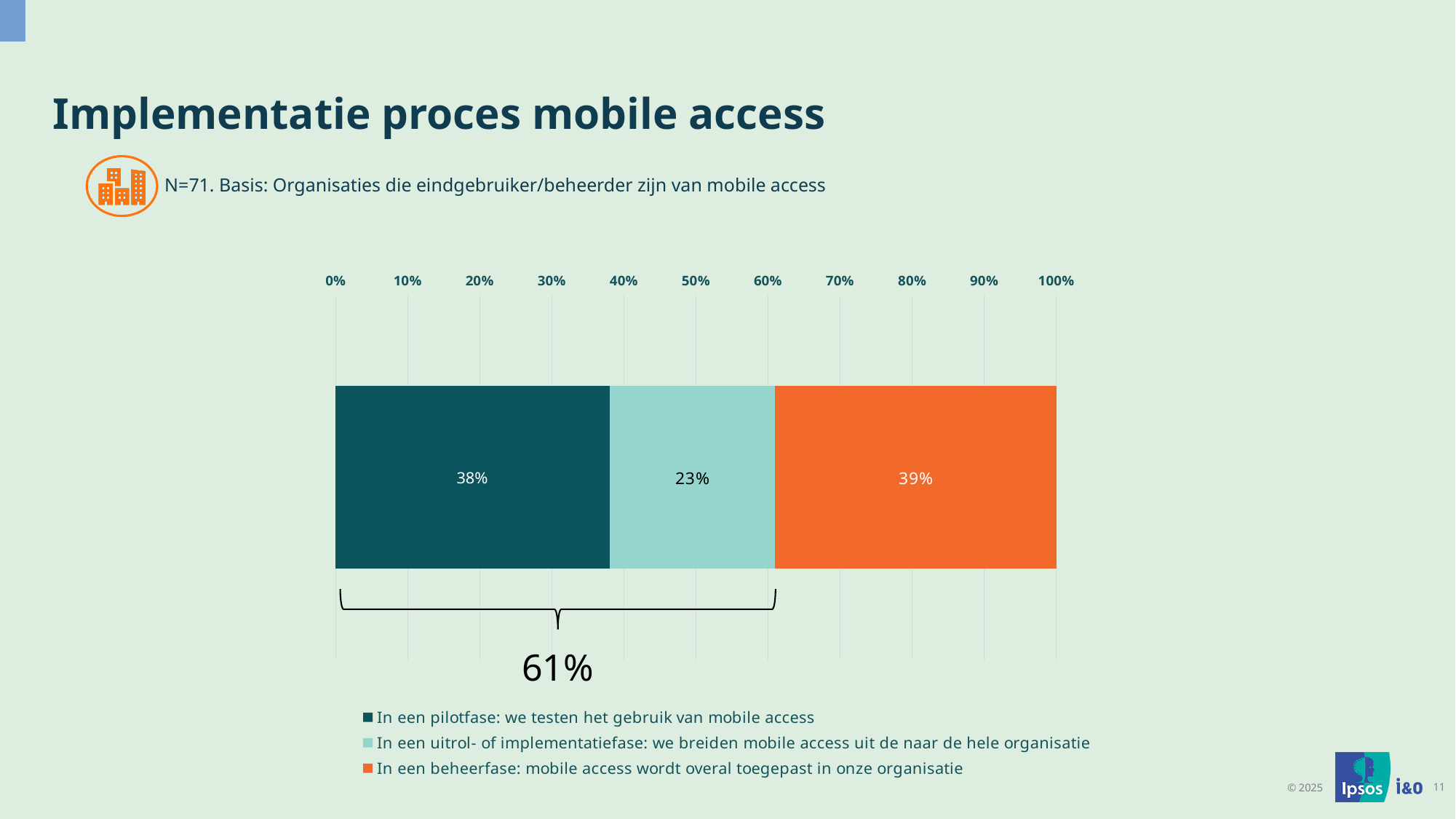
What is the sample size (N) stated on the slide? N=71 Which is larger: the share in the pilot phase or the share in the rollout/implementation phase? In een pilotfase What is the difference between the share in the pilot phase and the share in the rollout/implementation phase? 15% Which phase has the largest share of organisations? In een beheerfase: mobile access wordt overal toegepast in onze organisatie What percentage of organisations are in the pilot phase ('In een pilotfase')? 38% Which phase has the smallest share of organisations? In een uitrol- of implementatiefase: we breiden mobile access uit de naar de hele organisatie What kind of chart is shown on the slide? Stacked bar chart What percentage of organisations are in the management phase ('In een beheerfase')? 39% What combined percentage is shown by the bracket under the first two segments? 61% What colour is the segment for the management phase ('In een beheerfase')? Orange How many series does the legend list? 3 What percentage of organisations are in the rollout or implementation phase ('In een uitrol- of implementatiefase')? 23%